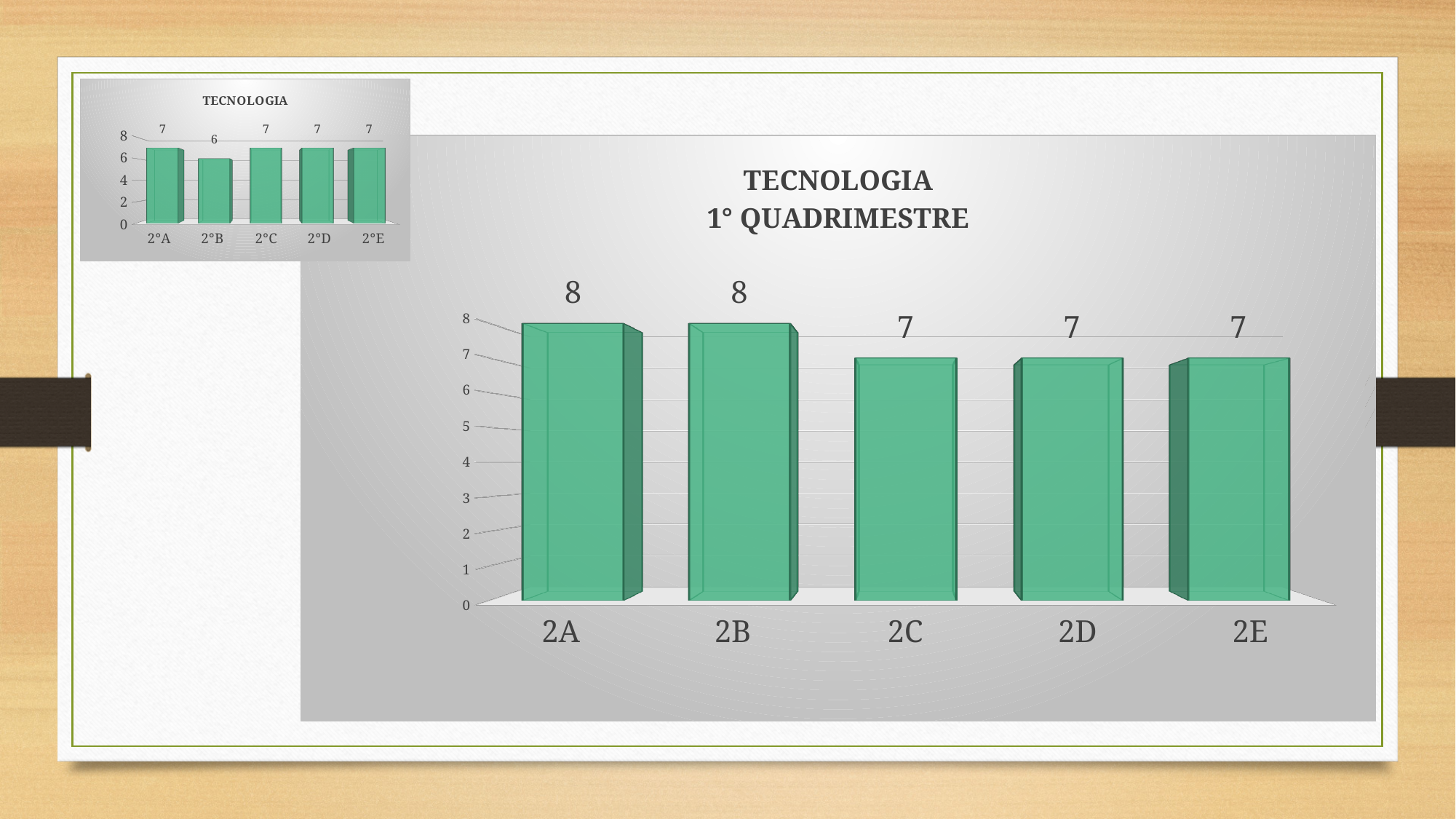
In the large chart titled TECNOLOGIA 1° QUADRIMESTRE, which is larger, the value for 2A or the value for 2D? 2A In the large chart titled TECNOLOGIA 1° QUADRIMESTRE, what is the value for 2A? 8 What is the title of the large chart on the slide? TECNOLOGIA 1° QUADRIMESTRE In the large chart titled TECNOLOGIA 1° QUADRIMESTRE, what is the value for 2C? 7 What kind of chart is the large chart titled TECNOLOGIA 1° QUADRIMESTRE? Bar chart In the large chart titled TECNOLOGIA 1° QUADRIMESTRE, do the values rise or fall from 2A to 2E? Fall In the small chart at the top left titled TECNOLOGIA, how many bars are shown? 5 In the large chart titled TECNOLOGIA 1° QUADRIMESTRE, how many categories are shown on the x axis? 5 In the small chart at the top left titled TECNOLOGIA, what is the value for 2°B? 6 In the large chart titled TECNOLOGIA 1° QUADRIMESTRE, what is the difference between the values for 2B and 2E? 1 In the small chart at the top left titled TECNOLOGIA, which category has the lowest value? 2°B In the small chart at the top left titled TECNOLOGIA, what is the difference between the values for 2°A and 2°B? 1